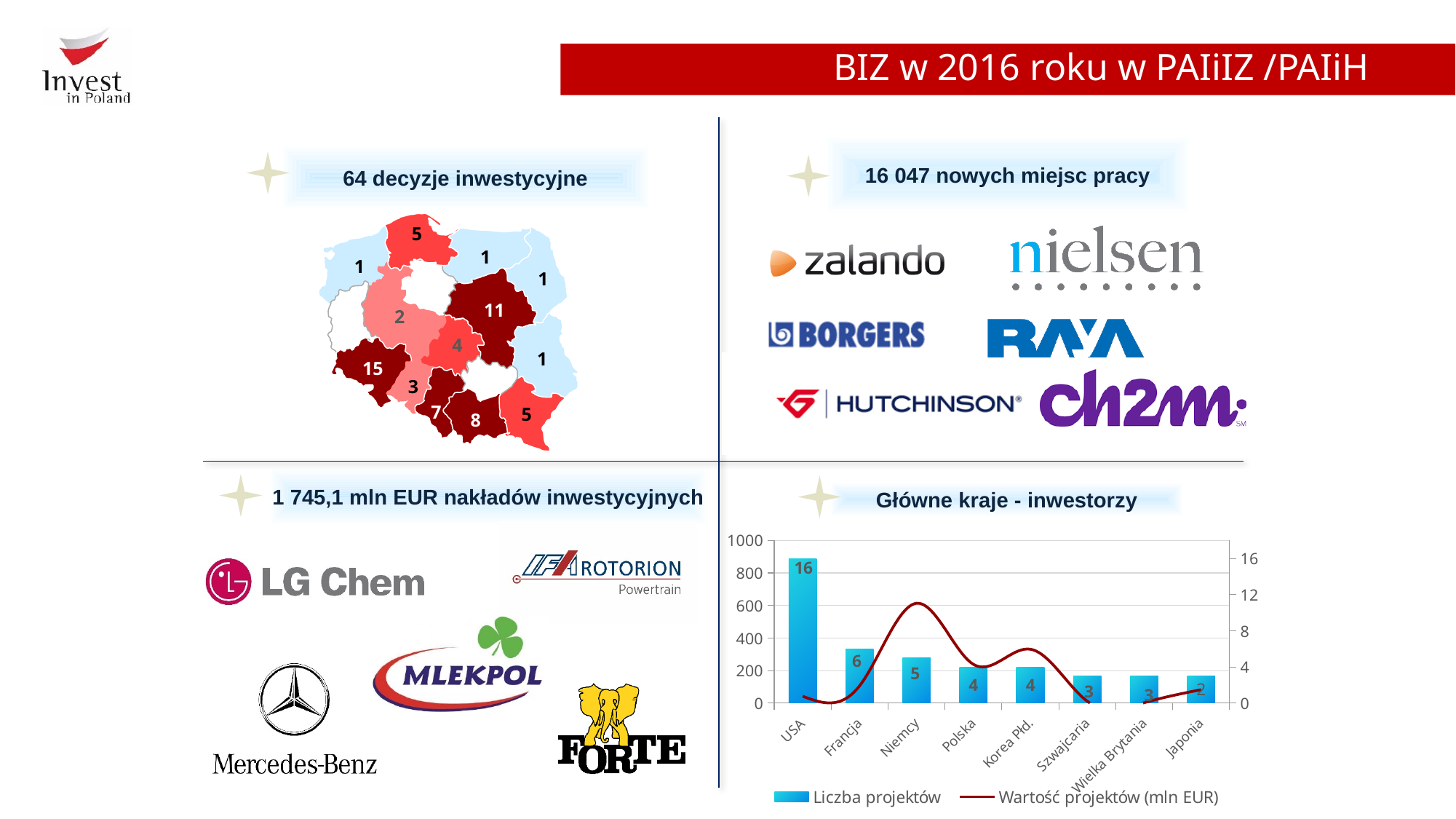
How many series does the legend of the 'Główne kraje - inwestorzy' chart list? 2 In the 'Główne kraje - inwestorzy' chart, which country has the lowest number of projects? Japonia In the 'Główne kraje - inwestorzy' chart, what is the difference in number of projects between USA and Francja? 10 In the 'Główne kraje - inwestorzy' chart, how many projects (Liczba projektów) are shown for USA? 16 What kind of chart is 'Główne kraje - inwestorzy'? A combined bar and line chart In the 'Główne kraje - inwestorzy' chart, which country has the highest number of projects? USA How many countries are shown on the x axis of the 'Główne kraje - inwestorzy' chart? 8 In the 'Główne kraje - inwestorzy' chart, what is the number of projects for Niemcy? 5 In the 'Główne kraje - inwestorzy' chart, which has more projects, Niemcy or Polska? Niemcy In the 'Główne kraje - inwestorzy' chart, what is the number of projects for Francja? 6 In the 'Główne kraje - inwestorzy' chart, is the value of projects (Wartość projektów) for Niemcy greater or less than 400? greater In the 'Główne kraje - inwestorzy' chart, is the value of projects (Wartość projektów) for USA greater or less than 200? less